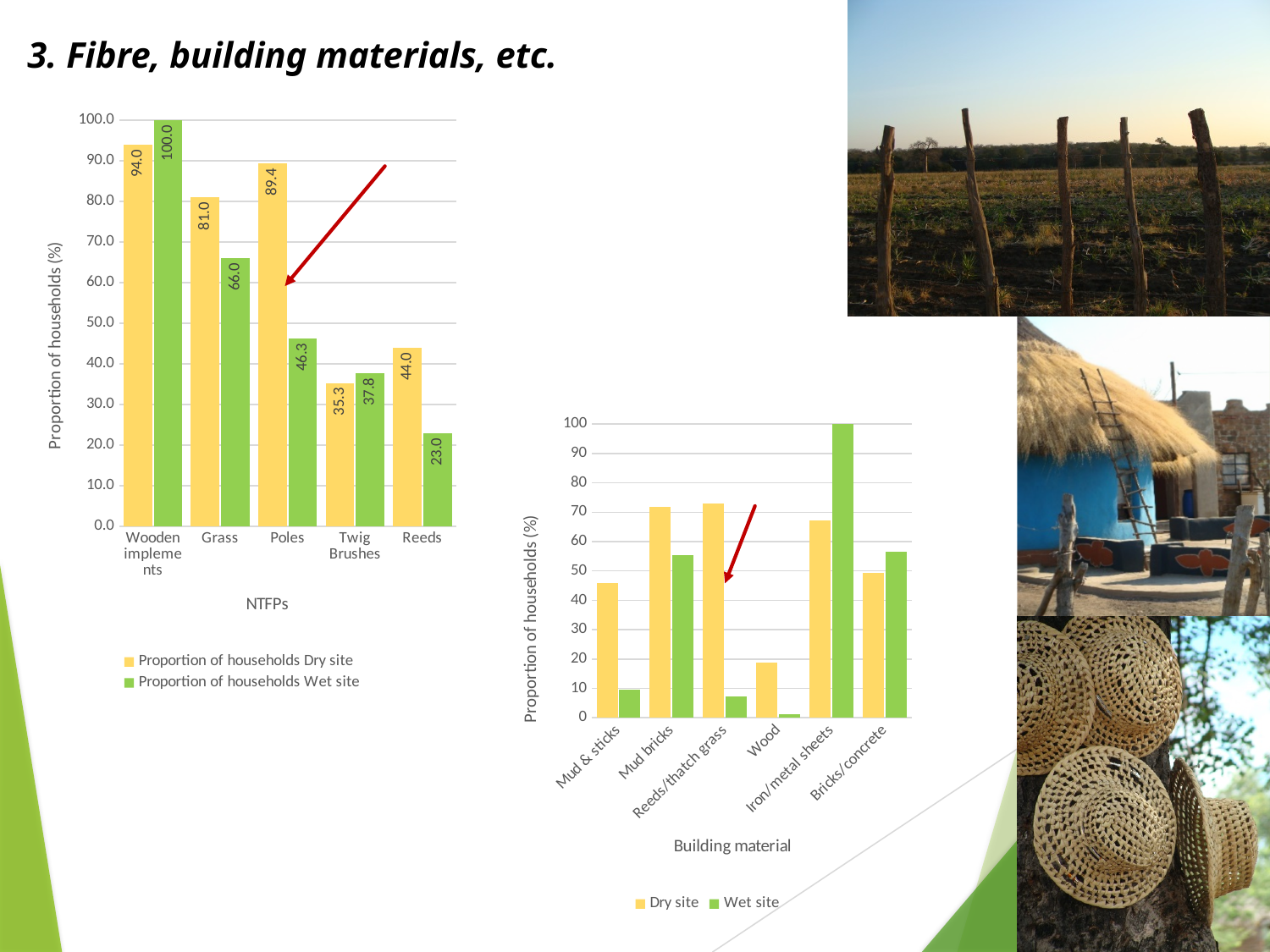
In the left chart (NTFPs), is the Dry site value for Grass larger or smaller than the Wet site value for Grass? larger In the left chart (NTFPs), what is the difference between the Dry site and Wet site values for Poles? 43.1 What type of chart is the right chart (Building material)? Bar chart In the left chart (NTFPs), which category has the lowest Dry site value? Twig Brushes In the right chart (Building material), is the Dry site value for Mud & sticks greater or less than 40? greater In the right chart (Building material), which building material has the highest Wet site value? Iron/metal sheets In the left chart (NTFPs), how many NTFP categories are shown on the x axis? 5 In the left chart (NTFPs), what is the proportion of households for Reeds at the Wet site? 23.0 In the left chart (NTFPs), what is the proportion of households for Poles at the Dry site? 89.4 In the right chart (Building material), how many series does the legend list? 2 In the left chart (NTFPs), which category has the highest Wet site value? Wooden implements In the right chart (Building material), which building material has the lowest Dry site value? Wood